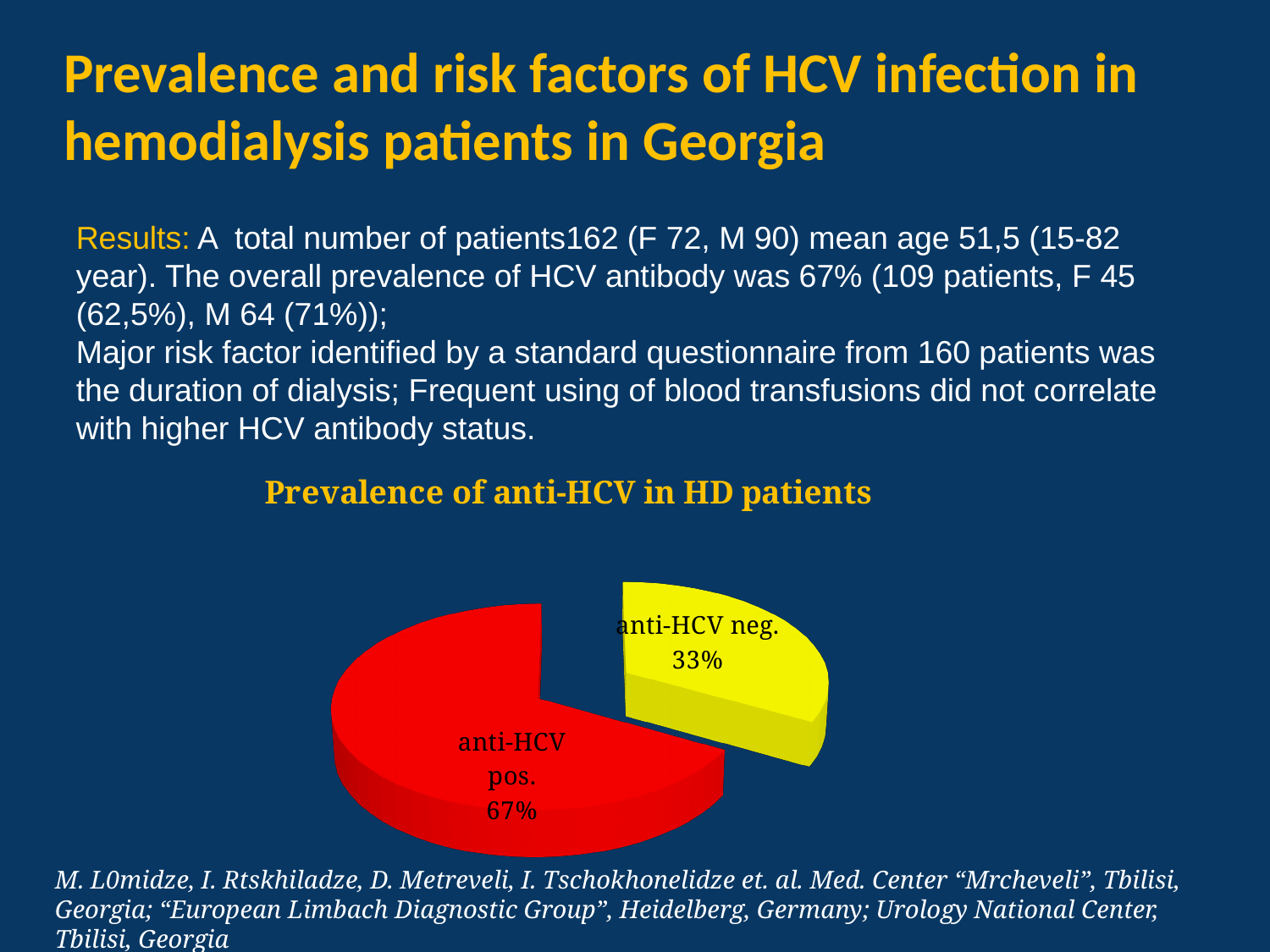
Which slice of the pie is the smallest? anti-HCV neg. How many slices does the pie chart have? 2 What type of chart is shown on the slide? Pie chart What percentage of HD patients are anti-HCV pos.? 67% What colour is the anti-HCV pos. slice? Red What is the title of the chart? Prevalence of anti-HCV in HD patients What percentage of HD patients are anti-HCV neg.? 33% Which slice of the pie is the largest? anti-HCV pos. What is the difference in percentage points between the anti-HCV pos. and anti-HCV neg. slices? 34 Which is larger, the anti-HCV pos. slice or the anti-HCV neg. slice? anti-HCV pos. What share of the pie does the anti-HCV neg. slice represent? 33%